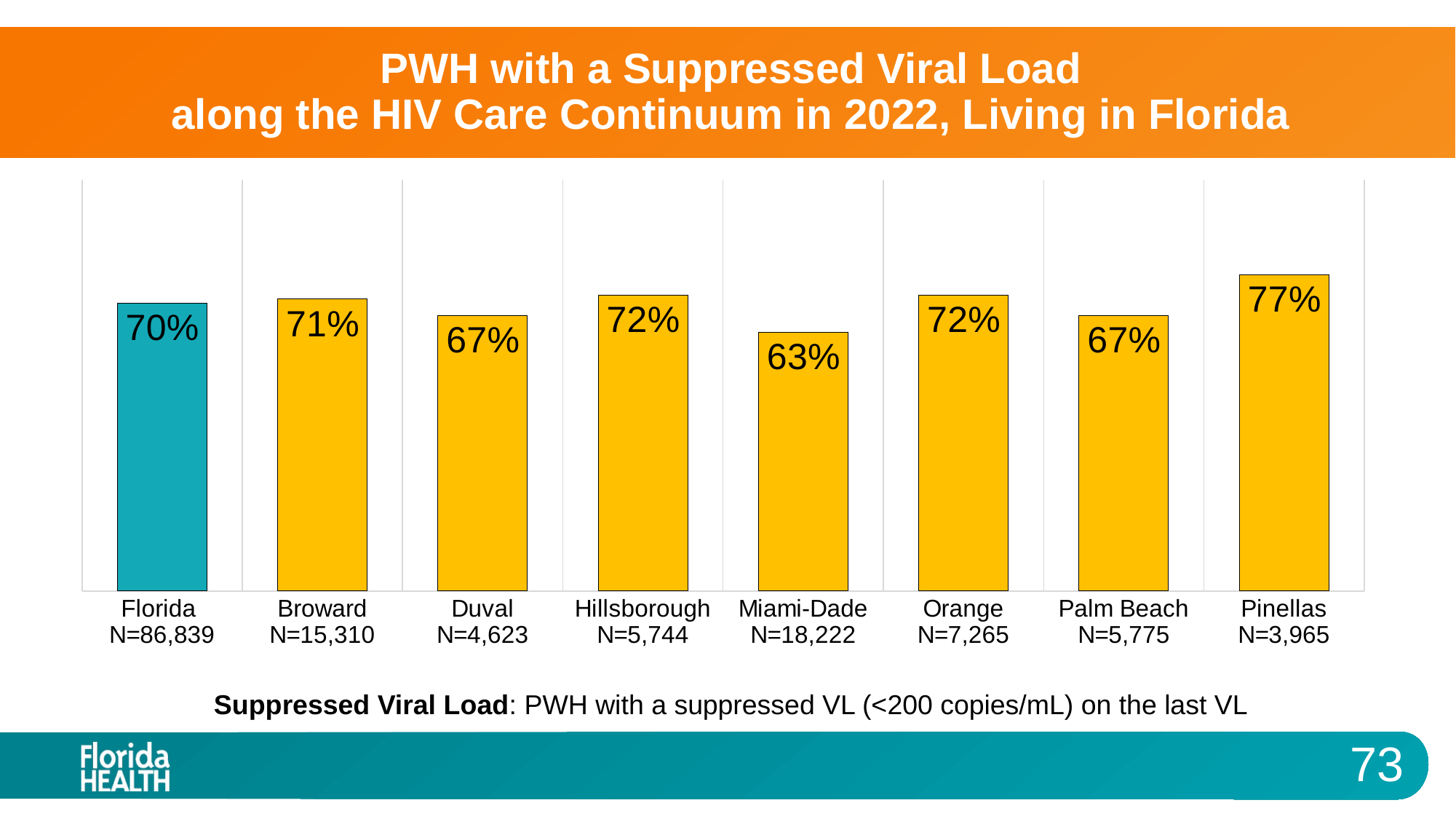
What is the value shown for Miami-Dade? 63% What percentage of PWH in Florida had a suppressed viral load? 70% What is the N value shown under the Broward label? N=15,310 Which has a higher value, Hillsborough or Palm Beach? Hillsborough Which category has the highest percentage with a suppressed viral load? Pinellas What is the difference in percentage points between Pinellas and Miami-Dade? 14 What kind of chart is shown on the slide? Bar chart Which bar is coloured differently (teal) from the others? Florida What is the value shown for Pinellas? 77% How many categories are shown on the chart? 8 Which category has the lowest percentage with a suppressed viral load? Miami-Dade What is the difference in percentage points between Broward and Duval? 4